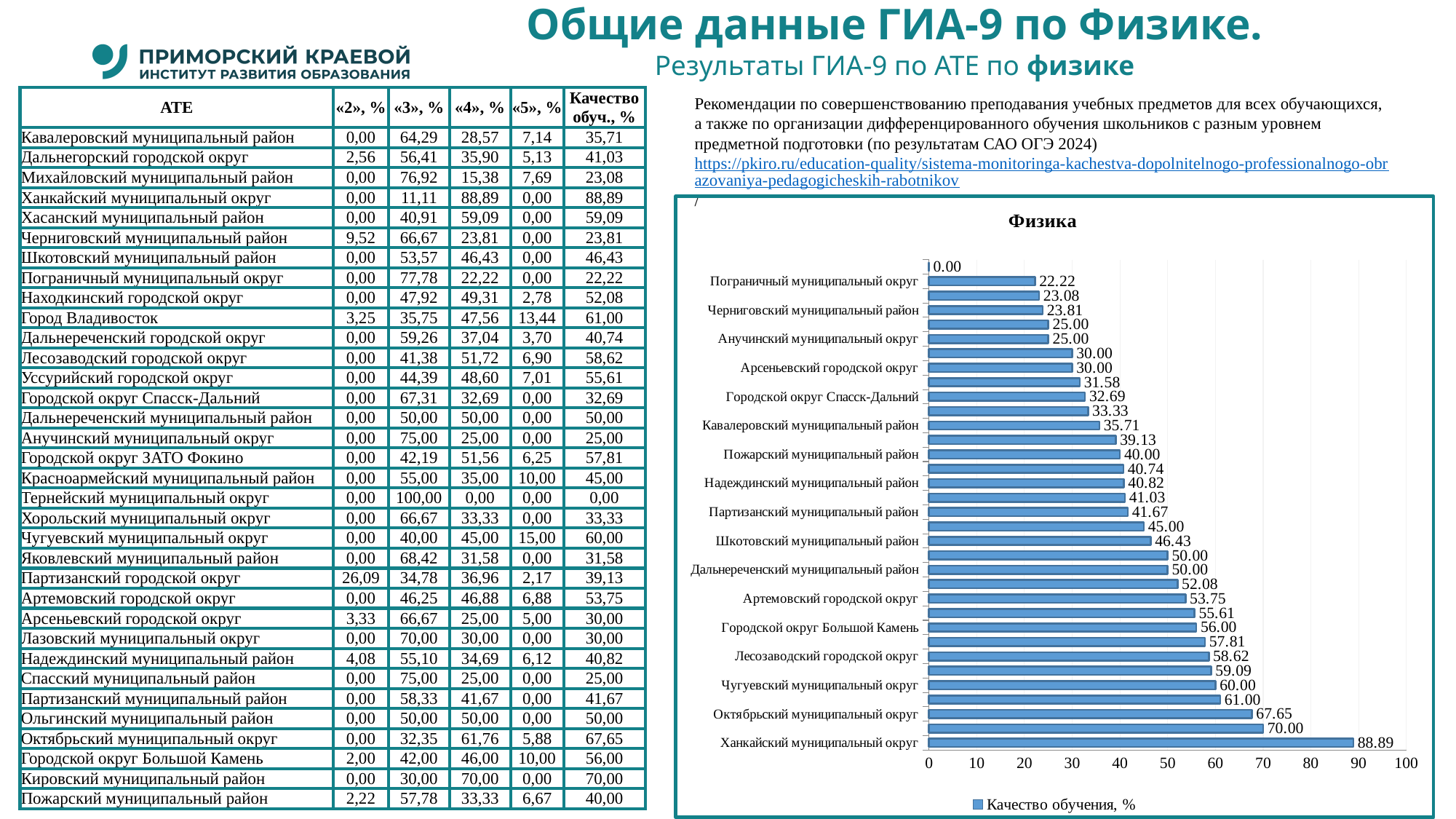
What is the value for Октябрьский муниципальный округ in the chart? 67.65 What is the value for Шкотовский муниципальный район in the chart? 46.43 How many series does the chart legend list? 1 Which has a larger value, Артемовский городской округ or Кавалеровский муниципальный район? Артемовский городской округ What is the value for Пограничный муниципальный округ in the chart? 22.22 Is the value for Лесозаводский городской округ greater or less than 50? greater What is the value for Ханкайский муниципальный округ in the chart? 88.89 What is the difference between the values for Чугуевский муниципальный округ and Пожарский муниципальный район? 20.00 What series does the chart legend list? Качество обучения, % Which category has the highest value in the chart? Ханкайский муниципальный округ What kind of chart is shown on the slide? Bar chart What is the title of the chart? Физика